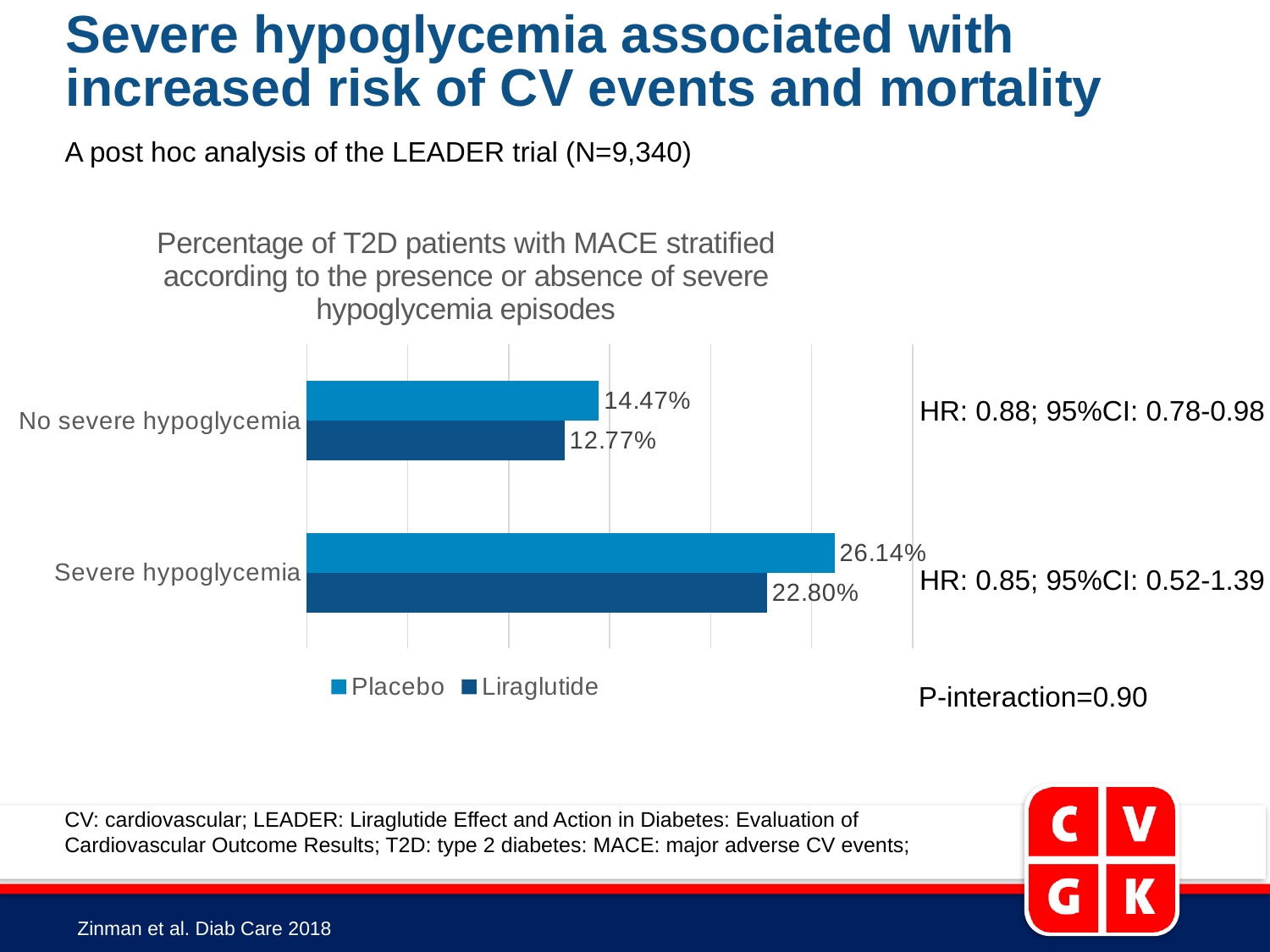
Which bar shows the lowest percentage of patients with MACE? Liraglutide, No severe hypoglycemia What is the difference between the placebo and liraglutide percentages in the severe hypoglycemia group? 3.34% What kind of chart is shown on the slide? Bar chart In the severe hypoglycemia group, which series has the larger percentage, Placebo or Liraglutide? Placebo What percentage of liraglutide patients with no severe hypoglycemia had MACE? 12.77% Which bar shows the highest percentage of patients with MACE? Placebo, Severe hypoglycemia How many categories are shown on the chart? 2 What is the difference between the placebo and liraglutide percentages in the no severe hypoglycemia group? 1.70% How many series does the legend list? 2 What percentage of placebo patients with severe hypoglycemia had MACE? 26.14% What percentage of placebo patients with no severe hypoglycemia had MACE? 14.47% What percentage of liraglutide patients with severe hypoglycemia had MACE? 22.80%